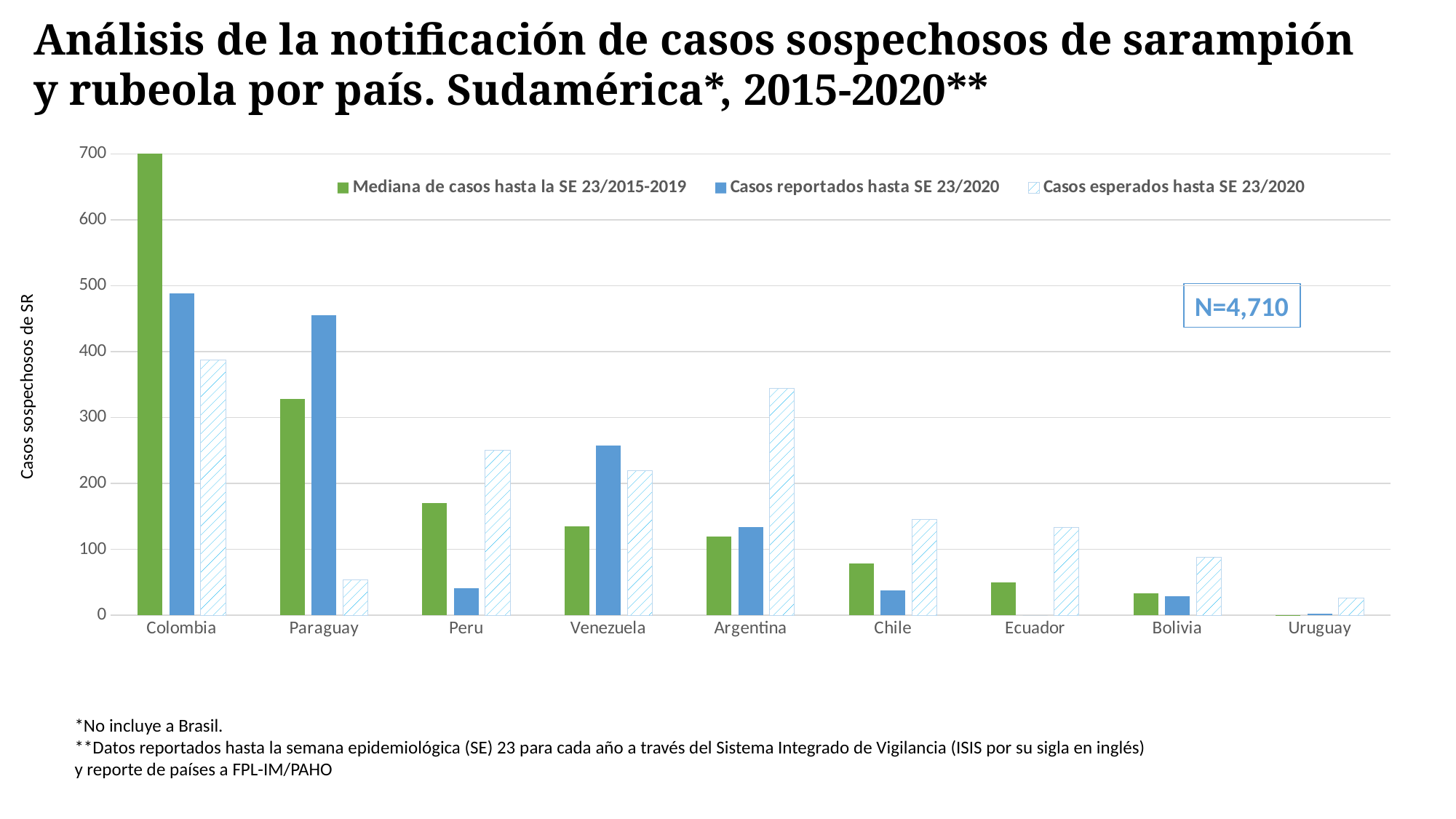
What kind of chart is shown on the slide? Bar chart Is the value of Casos esperados hasta SE 23/2020 for Peru greater or less than 200? greater Is the value of Casos esperados hasta SE 23/2020 for Argentina greater or less than 300? greater Which country has the lowest value for Casos esperados hasta SE 23/2020? Uruguay Which country has the highest value for Mediana de casos hasta la SE 23/2015-2019? Colombia Which country has the highest value for Casos reportados hasta SE 23/2020? Colombia For Venezuela, which is larger: Casos reportados hasta SE 23/2020 or Mediana de casos hasta la SE 23/2015-2019? Casos reportados hasta SE 23/2020 How many countries are shown on the x axis? 9 What N value is shown in the box on the chart? N=4,710 Is the value of Casos reportados hasta SE 23/2020 for Paraguay greater or less than 400? greater How many series does the legend list? 3 For Paraguay, which is larger: Casos reportados hasta SE 23/2020 or Casos esperados hasta SE 23/2020? Casos reportados hasta SE 23/2020